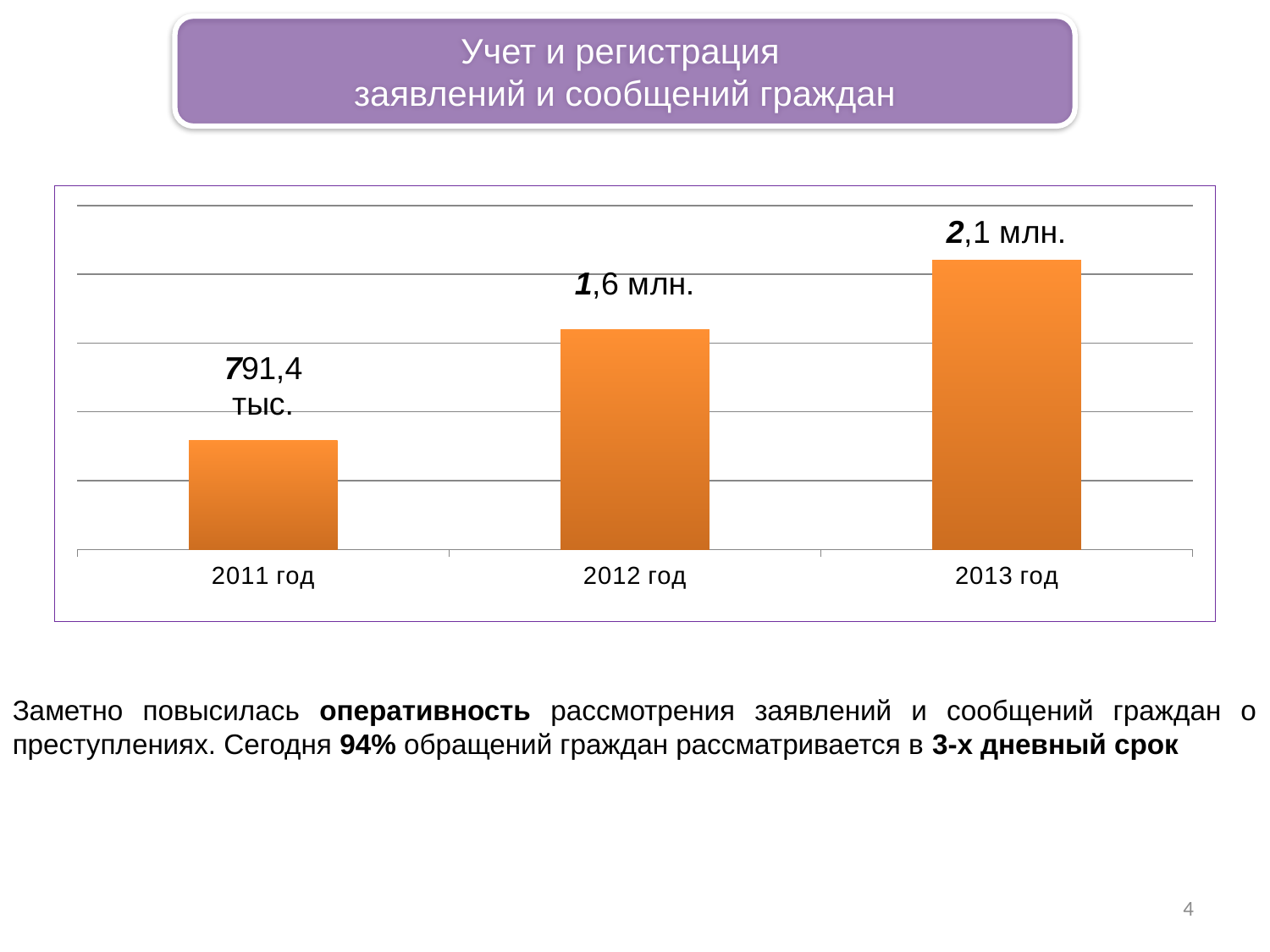
What is the difference between the values for 2013 год and 2012 год? 0,5 млн. How many years are shown on the chart? 3 Which is larger, the value for 2012 год or the value for 2011 год? 2012 год What colour are the bars in the chart? orange Do the values rise or fall from 2011 год to 2013 год? rise Which year has the lowest value? 2011 год Which is larger, the value for 2013 год or the value for 2012 год? 2013 год What is the value shown for 2013 год? 2,1 млн. Which year has the highest value? 2013 год What kind of chart is shown on the slide? bar chart What is the value shown for 2012 год? 1,6 млн. What is the value shown for 2011 год? 791,4 тыс.